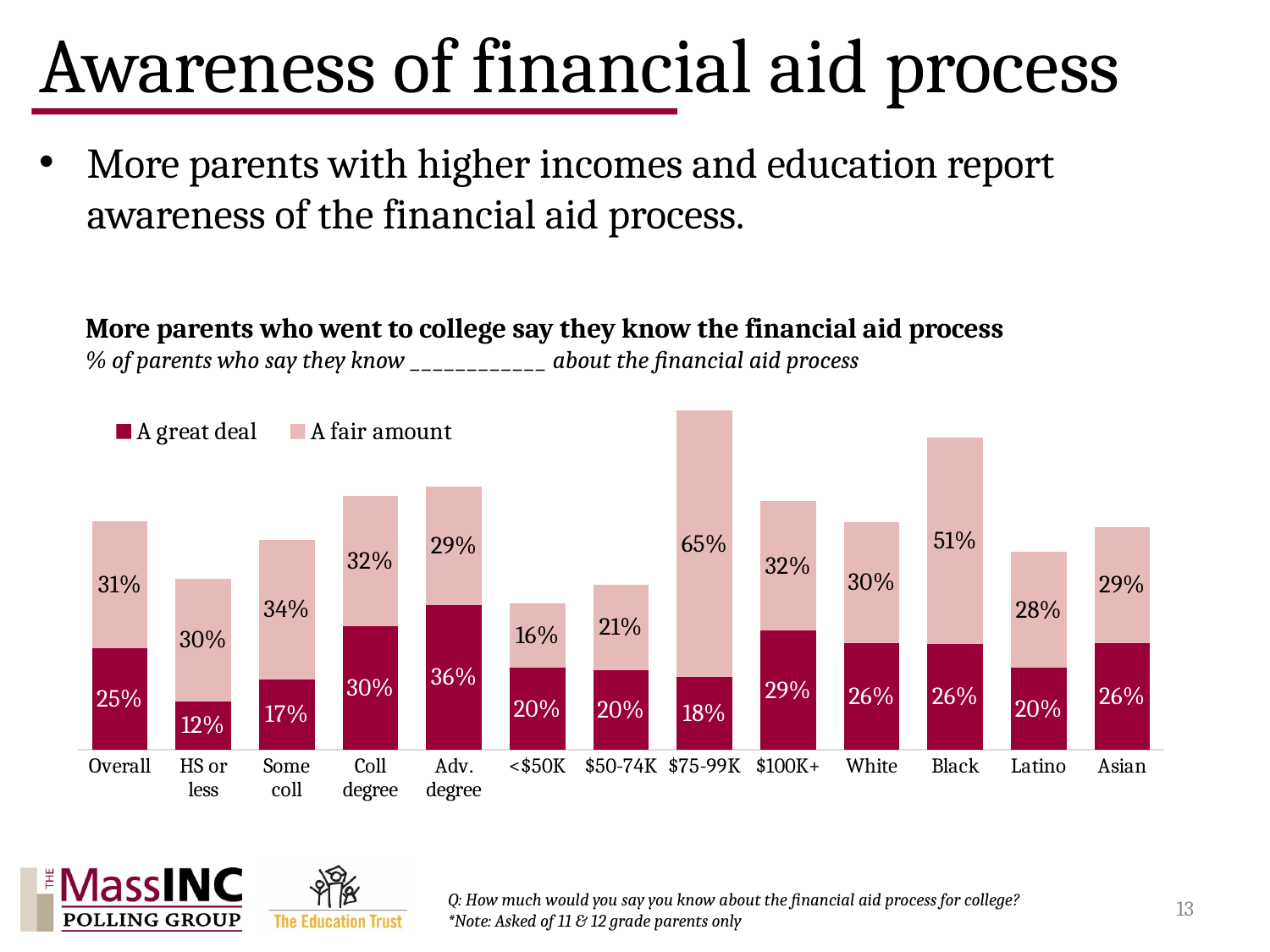
Which category has the lowest "A fair amount" value? <$50K What percentage of parents with an advanced degree say they know "A great deal" about the financial aid process? 36% What type of chart is shown on the slide? Stacked bar chart Which is larger: the "A fair amount" value for Black parents or for White parents? Black How many categories are shown on the x axis of the chart? 13 Which category has the lowest "A great deal" value? HS or less What is the combined total of "A great deal" and "A fair amount" for the $75-99K group? 83% What is the difference between the "A great deal" values for Coll degree and HS or less? 18% What is the combined total of "A great deal" and "A fair amount" for the Overall category? 56% How many series does the chart's legend list? 2 What is the "A fair amount" value for the $75-99K income group? 65% Which category has the highest "A great deal" value? Adv. degree